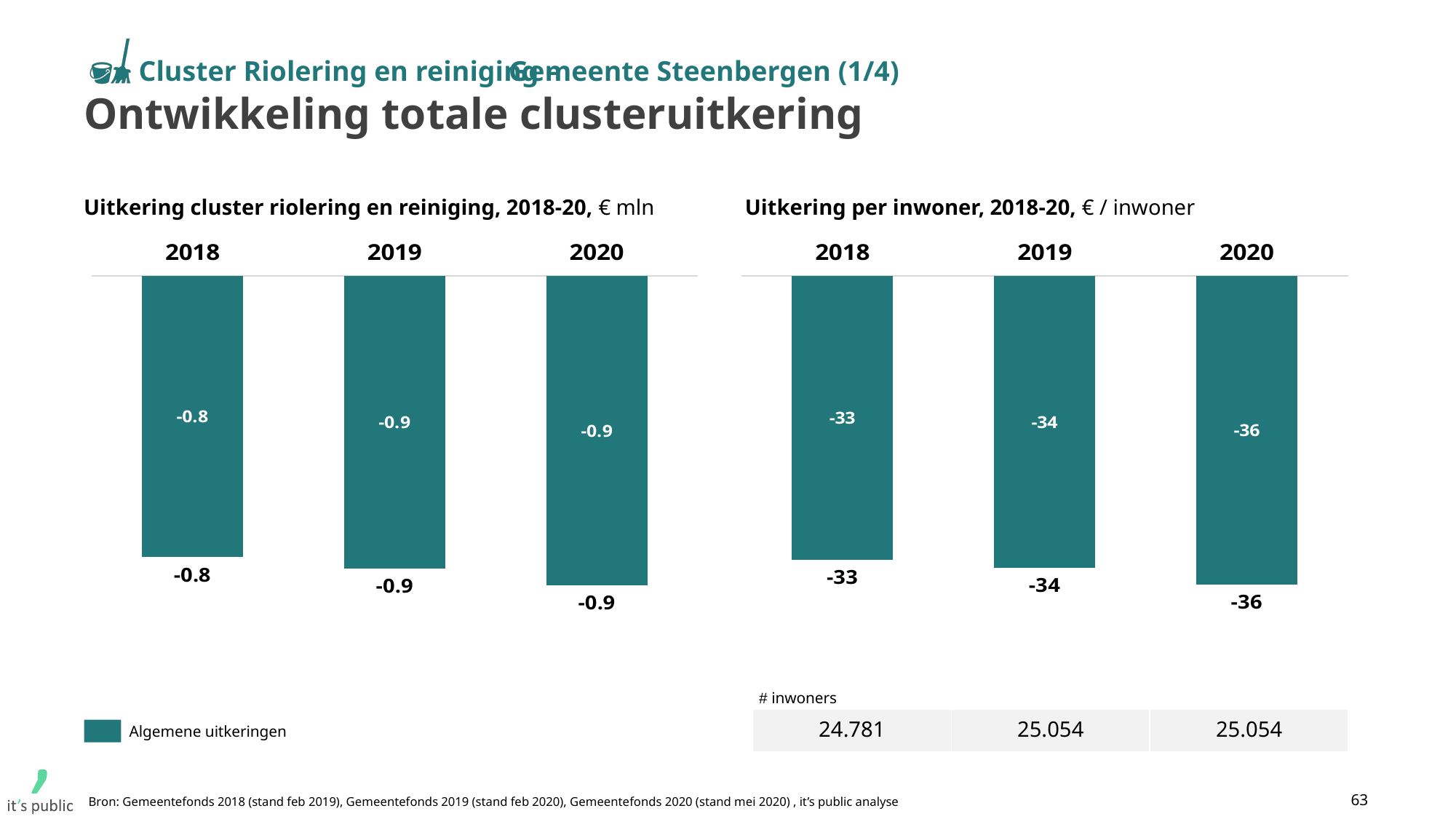
What is the legend entry shown below the left chart? Algemene uitkeringen In the chart 'Uitkering cluster riolering en reiniging, 2018-20', what is the value for 2020? -0.9 How many years are shown in the chart 'Uitkering cluster riolering en reiniging, 2018-20'? 3 In the chart 'Uitkering per inwoner, 2018-20', what is the difference between the values for 2018 and 2020? 3 In the chart 'Uitkering per inwoner, 2018-20', what is the value for 2020? -36 In the chart 'Uitkering cluster riolering en reiniging, 2018-20', what is the difference between the values for 2018 and 2019? 0.1 In the chart 'Uitkering per inwoner, 2018-20', is the value for 2018 larger or smaller than the value for 2019? larger What kind of chart is 'Uitkering per inwoner, 2018-20'? bar chart In the chart 'Uitkering cluster riolering en reiniging, 2018-20', what is the value for 2018? -0.8 In the chart 'Uitkering per inwoner, 2018-20', what is the value for 2019? -34 In the chart 'Uitkering per inwoner, 2018-20', which year has the lowest value? 2020 In the chart 'Uitkering per inwoner, 2018-20', which year has the highest value? 2018